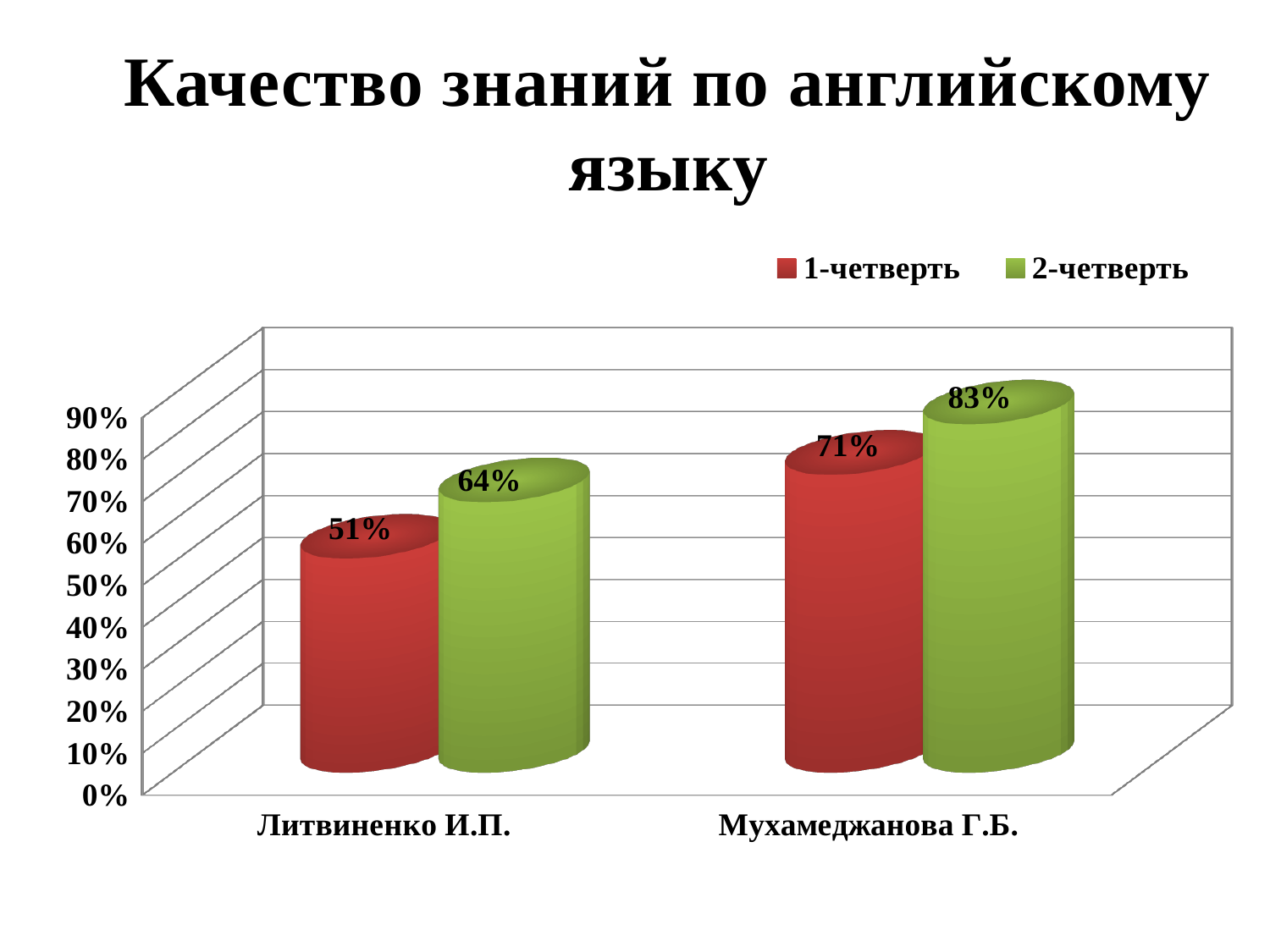
What is the difference between the 2-четверть and 1-четверть values for Литвиненко И.П.? 13% What kind of chart is shown on the slide? Bar chart What is the difference between the 2-четверть and 1-четверть values for Мухамеджанова Г.Б.? 12% What is the value for Литвиненко И.П. in 2-четверть? 64% Which teacher has the highest value in 2-четверть? Мухамеджанова Г.Б. What is the value for Мухамеджанова Г.Б. in 2-четверть? 83% What is the value for Литвиненко И.П. in 1-четверть? 51% Which is larger: the 1-четверть value for Мухамеджанова Г.Б. or the 2-четверть value for Литвиненко И.П.? 1-четверть value for Мухамеджанова Г.Б. Which teacher has the lowest value in 1-четверть? Литвиненко И.П. How many teachers (categories) are shown on the chart? 2 What is the value for Мухамеджанова Г.Б. in 1-четверть? 71% How many series does the legend list? 2